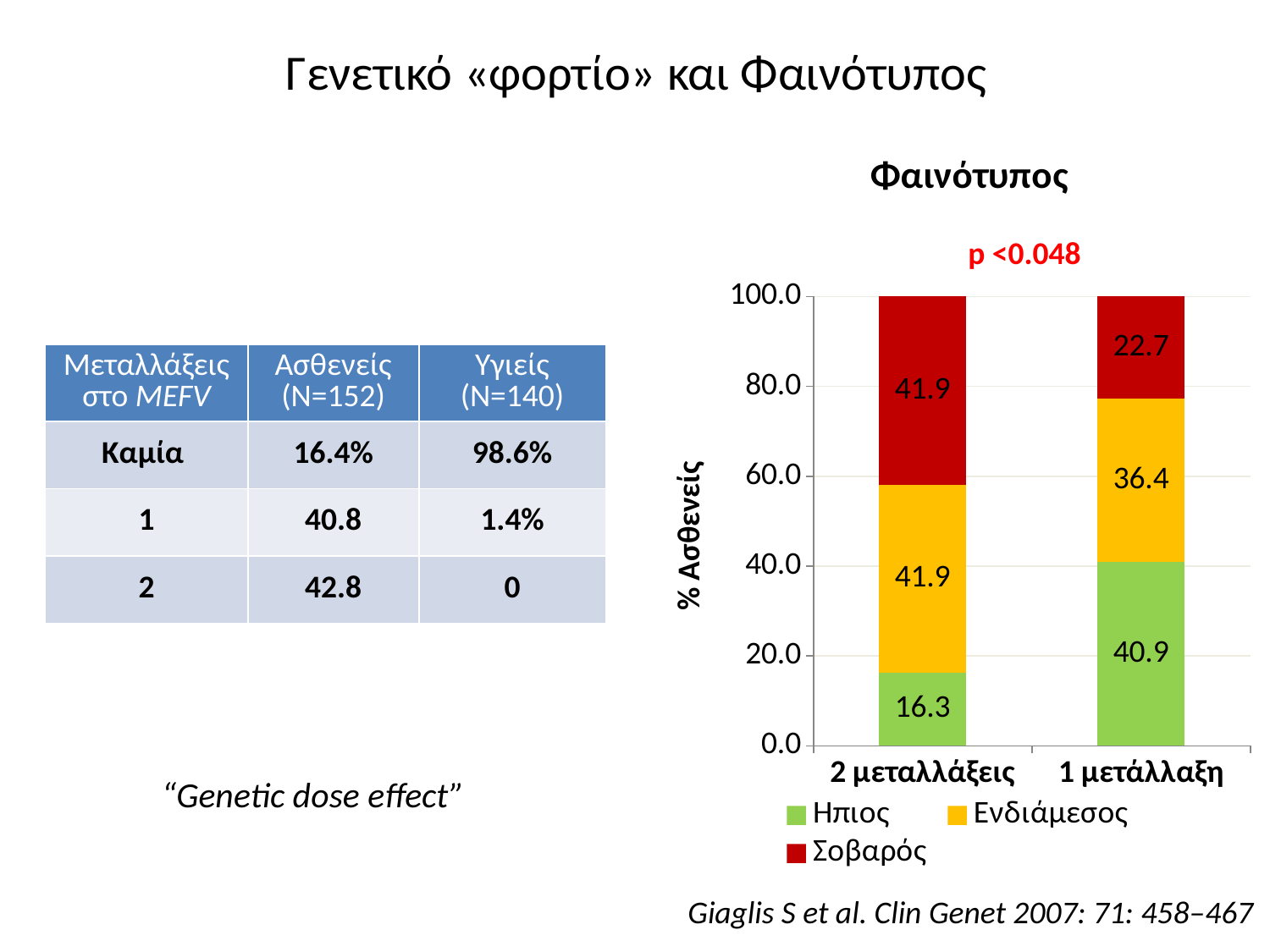
What is the value of Ενδιάμεσος for 1 μετάλλαξη? 36.4 How many series does the chart legend list? 3 What type of chart is shown on the slide? Stacked bar chart Which category has the higher value for Ήπιος, 2 μεταλλάξεις or 1 μετάλλαξη? 1 μετάλλαξη What is the difference between the Σοβαρός values for 2 μεταλλάξεις and 1 μετάλλαξη? 19.2 What is the label of the y axis of the chart? % Ασθενείς What is the value of Ήπιος for 2 μεταλλάξεις? 16.3 What is the title of the chart? Φαινότυπος How many categories are shown on the x axis of the chart? 2 What is the value of Σοβαρός for 2 μεταλλάξεις? 41.9 What is the value of Σοβαρός for 1 μετάλλαξη? 22.7 What is the difference between the Ήπιος values for 1 μετάλλαξη and 2 μεταλλάξεις? 24.6